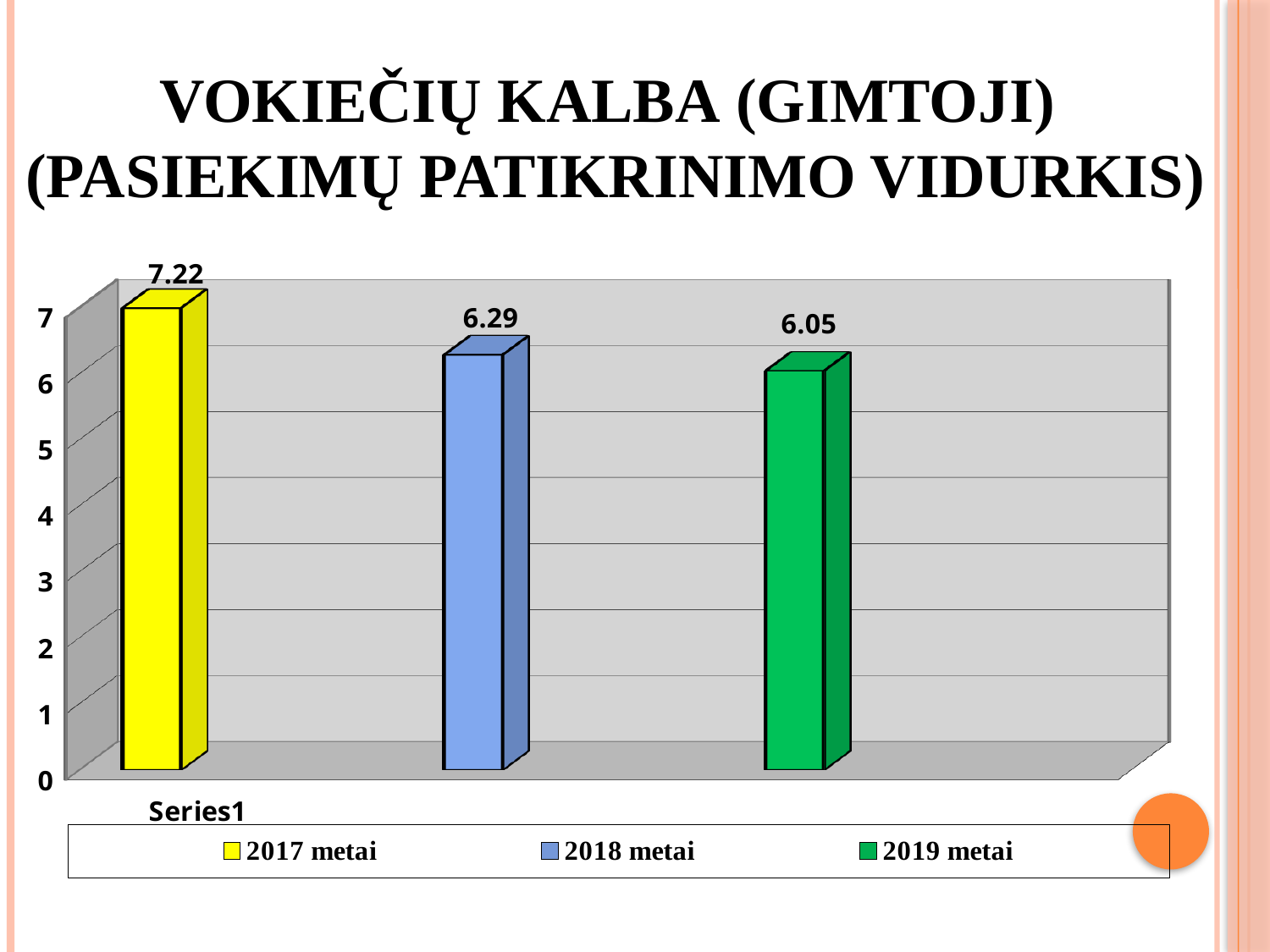
What kind of chart is shown on the slide? bar chart Do the values rise or fall from 2017 metai to 2019 metai? fall What is the value for 2019 metai? 6.05 Which year has the highest value? 2017 metai Which year has the lowest value? 2019 metai Is the value for 2019 metai greater or less than 7? less What is the value for 2017 metai? 7.22 What is the difference between the values for 2018 metai and 2019 metai? 0.24 How many series does the legend list? 3 What is the value for 2018 metai? 6.29 What is the difference between the values for 2017 metai and 2019 metai? 1.17 Which is larger, the value for 2017 metai or 2018 metai? 2017 metai